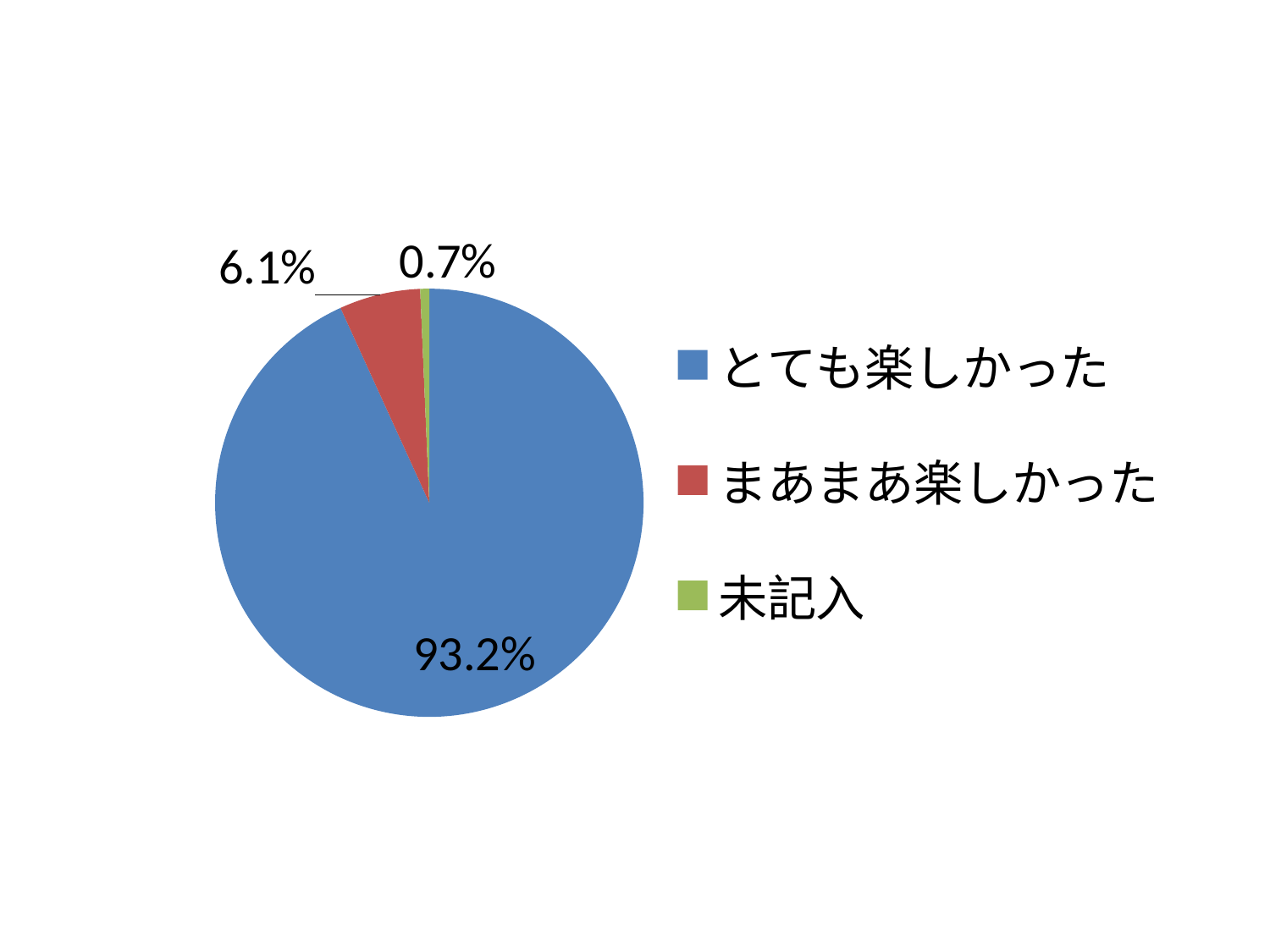
What colour is the slice for とても楽しかった? blue Which category has the smallest slice of the pie? 未記入 Which is larger, the slice for まあまあ楽しかった or the slice for 未記入? まあまあ楽しかった What kind of chart is shown on the slide? pie chart What is the difference in percentage points between とても楽しかった and まあまあ楽しかった? 87.1 Which category has the largest slice of the pie? とても楽しかった What share of the pie is labelled 未記入? 0.7% Which legend entry is shown in green? 未記入 What share of the pie is labelled とても楽しかった? 93.2% How many categories does the pie chart have? 3 What is the difference in percentage points between まあまあ楽しかった and 未記入? 5.4 What share of the pie is labelled まあまあ楽しかった? 6.1%